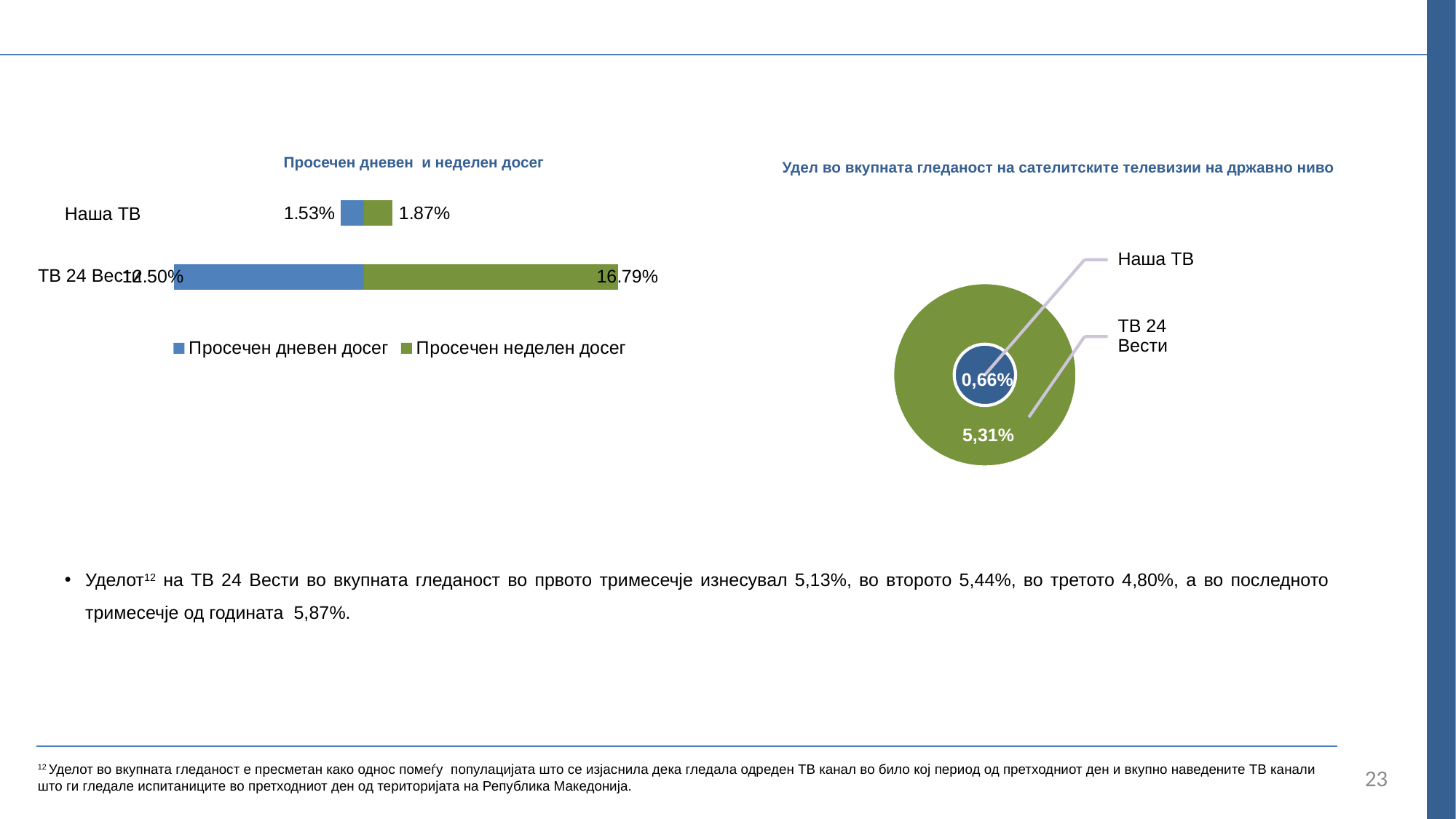
In the chart titled 'Удел во вкупната гледаност на сателитските телевизии на државно ниво', which channel has the larger share? ТВ 24 Вести In the chart titled 'Просечен дневен и неделен досег', how many channels are shown? 2 What kind of chart is the one titled 'Просечен дневен и неделен досег'? Bar chart In the chart titled 'Просечен дневен и неделен досег', how many series does the legend list? 2 In the chart titled 'Просечен дневен и неделен досег', what is the average weekly reach (Просечен неделен досег) for ТВ 24 Вести? 16.79% In the chart titled 'Удел во вкупната гледаност на сателитските телевизии на државно ниво', what is the share for ТВ 24 Вести? 5,31% In the chart titled 'Просечен дневен и неделен досег', what is the average weekly reach (Просечен неделен досег) for Наша ТВ? 1.87% In the chart titled 'Просечен дневен и неделен досег', which channel has the lower average daily reach? Наша ТВ In the chart titled 'Просечен дневен и неделен досег', which channel has the higher average weekly reach? ТВ 24 Вести In the chart titled 'Удел во вкупната гледаност на сателитските телевизии на државно ниво', what is the share for Наша ТВ? 0,66% In the chart titled 'Просечен дневен и неделен досег', what is the average daily reach (Просечен дневен досег) for Наша ТВ? 1.53% In the chart titled 'Просечен дневен и неделен досег', what is the difference between the average weekly reach and the average daily reach for Наша ТВ? 0.34%